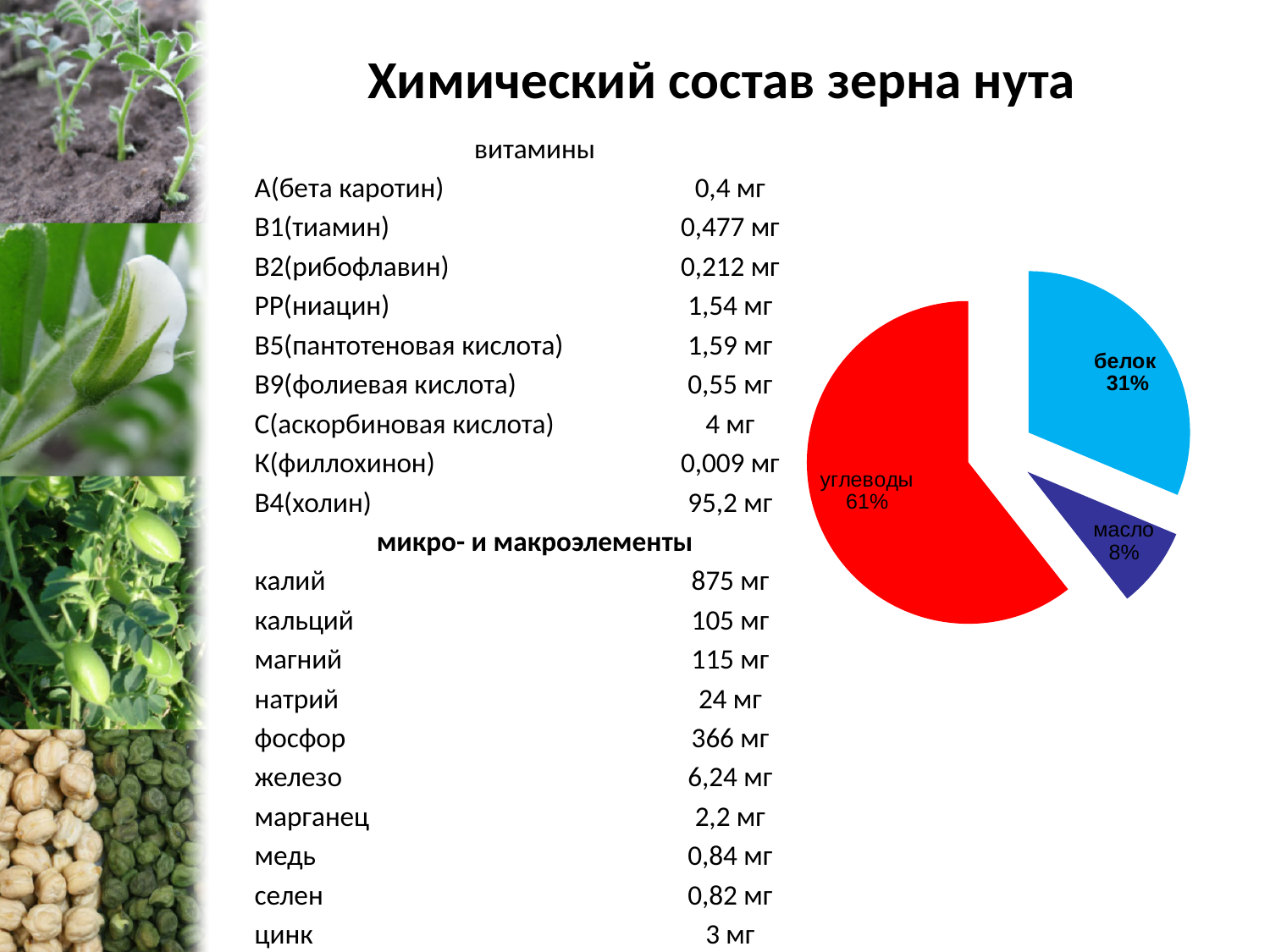
What share of the pie chart is labelled углеводы? 61% Which slice of the pie chart is the largest? углеводы What is the difference in percentage points between the белок slice and the масло slice? 23 What colour is the углеводы slice in the pie chart? red What kind of chart is shown on the slide? pie chart What share of the pie chart is labelled масло? 8% What share of the pie chart is labelled белок? 31% Which is larger in the pie chart, белок or масло? белок Which slice of the pie chart is the smallest? масло What colour is the белок slice in the pie chart? light blue What is the difference in percentage points between the углеводы slice and the белок slice? 30 How many slices does the pie chart have? 3